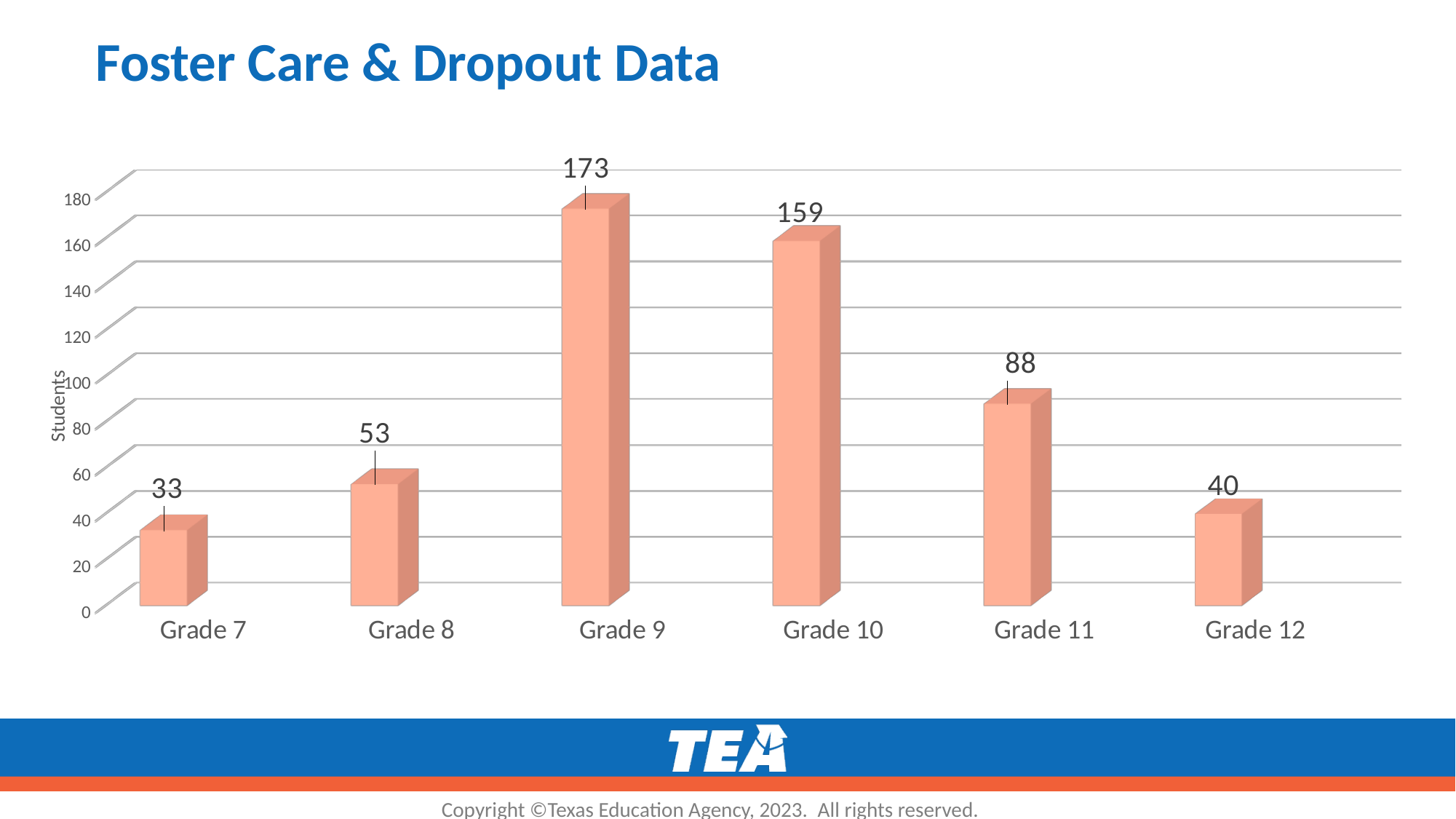
What is the value for Grade 7? 33 What is the difference between the values for Grade 9 and Grade 10? 14 Is the value for Grade 10 greater or less than 140? greater Which is larger, the value for Grade 8 or the value for Grade 12? Grade 8 What is the value for Grade 11? 88 How many students are shown for Grade 9? 173 Which grade has the highest number of students? Grade 9 Which grade has the lowest number of students? Grade 7 How many grade categories are shown on the chart? 6 What is the difference between the values for Grade 8 and Grade 12? 13 What kind of chart is shown on the slide? bar chart What is the label on the vertical axis of the chart? Students